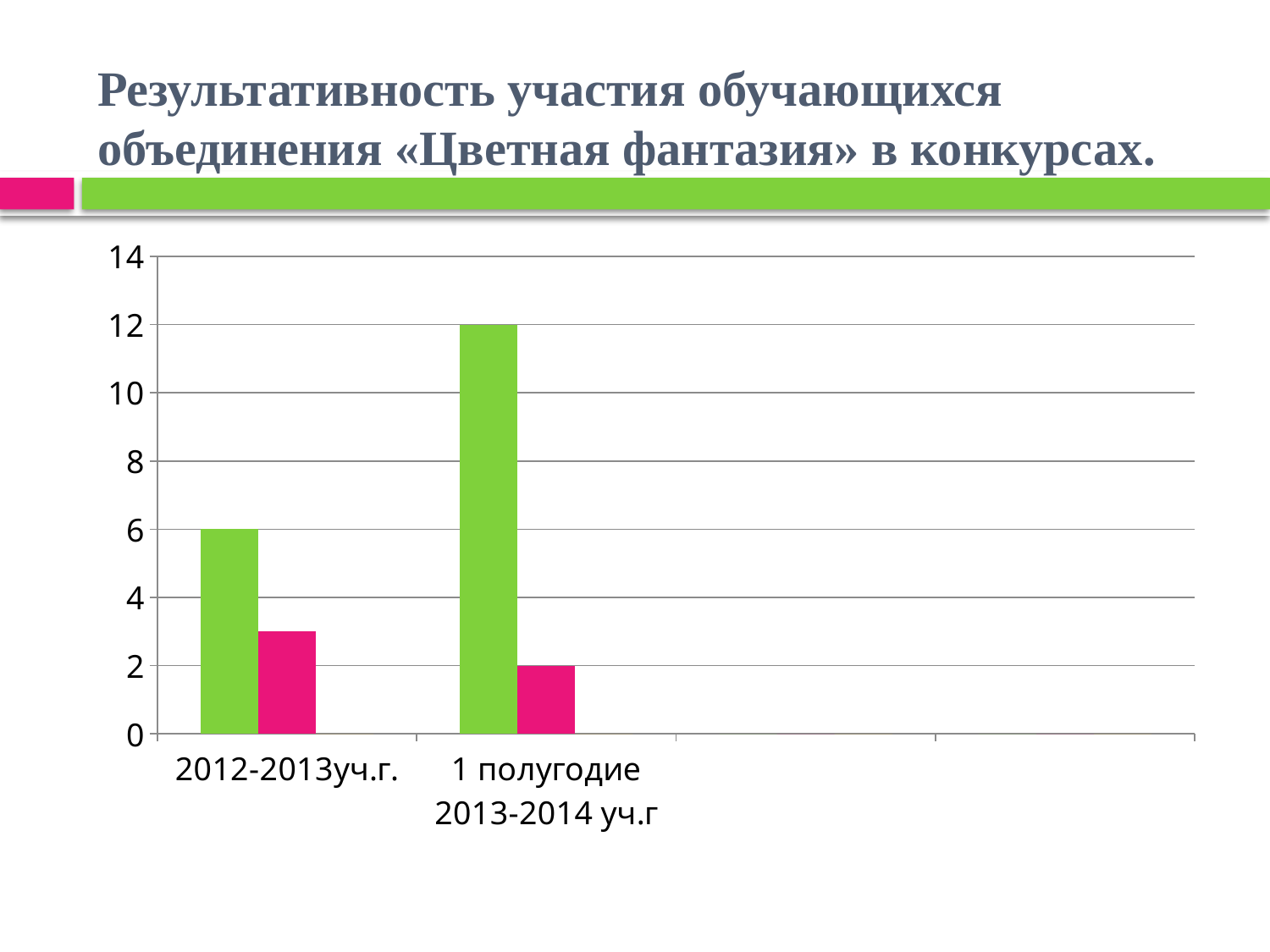
Which category has the higher green bar: 2012-2013уч.г. or 1 полугодие 2013-2014 уч.г? 1 полугодие 2013-2014 уч.г What colours are the two series of bars in the chart? green and pink What is the value of the pink bar for 1 полугодие 2013-2014 уч.г? 2 What is the value of the green bar for 2012-2013уч.г.? 6 Do the green bars rise or fall from 2012-2013уч.г. to 1 полугодие 2013-2014 уч.г? rise What is the value of the green bar for 1 полугодие 2013-2014 уч.г? 12 How many categories are shown on the x axis of the chart? 2 What kind of chart is shown on the slide? bar chart Which category has the higher pink bar: 2012-2013уч.г. or 1 полугодие 2013-2014 уч.г? 2012-2013уч.г. Is the value of the pink bar for 2012-2013уч.г. greater or less than 4? less What is the difference between the green bars for 1 полугодие 2013-2014 уч.г and 2012-2013уч.г.? 6 Is the value of the pink bar for 2012-2013уч.г. greater or less than 2? greater